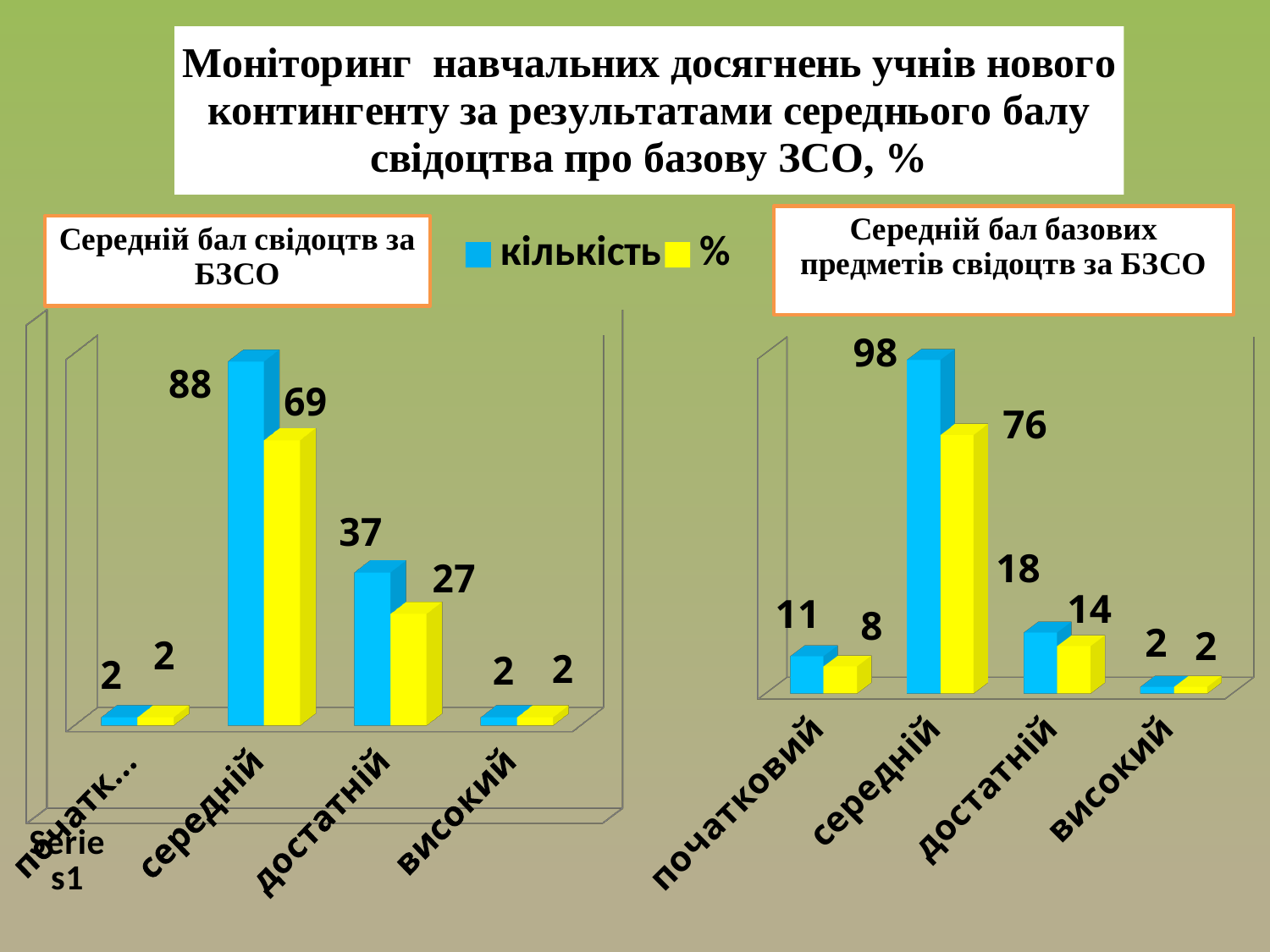
In the right chart (Середній бал базових предметів свідоцтв за БЗСО), what is the difference between the кількість values for середній and достатній? 80 In the right chart (Середній бал базових предметів свідоцтв за БЗСО), what is the % value for середній? 76 In the right chart (Середній бал базових предметів свідоцтв за БЗСО), which category has the highest кількість value? середній How many series does the legend list? 2 In the right chart (Середній бал базових предметів свідоцтв за БЗСО), which is larger: the % value for початковий or the % value for достатній? достатній In the left chart (Середній бал свідоцтв за БЗСО), which category has the highest % value? середній In the left chart (Середній бал свідоцтв за БЗСО), what is the difference between the кількість and % values for середній? 19 In the right chart (Середній бал базових предметів свідоцтв за БЗСО), which category has the lowest кількість value? високий In the right chart (Середній бал базових предметів свідоцтв за БЗСО), what is the кількість value for початковий? 11 In the left chart (Середній бал свідоцтв за БЗСО), what is the кількість value for середній? 88 In the left chart (Середній бал свідоцтв за БЗСО), what is the % value for достатній? 27 What kind of chart is the right chart (Середній бал базових предметів свідоцтв за БЗСО)? bar chart